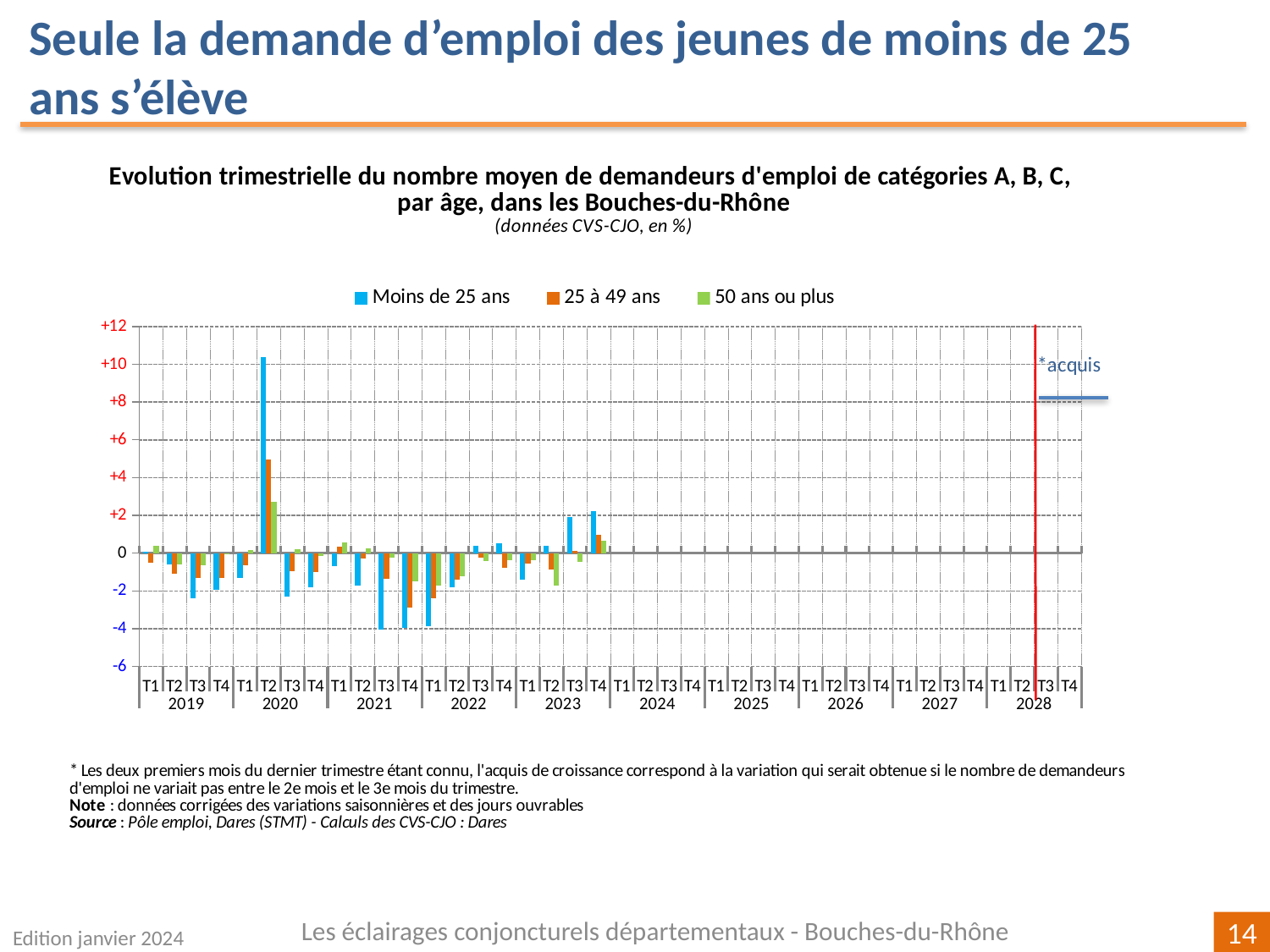
Is the value for '50 ans ou plus' in T2 2020 greater or less than +2? greater In T3 2019, which is larger: the value for 'Moins de 25 ans' or the value for '50 ans ou plus'? 50 ans ou plus In which quarter does the 'Moins de 25 ans' series reach its highest value? T2 2020 What kind of chart is shown on the slide? Bar chart Is the value for '25 à 49 ans' in T2 2020 greater or less than +4? greater In T2 2020, which series has the highest value? Moins de 25 ans How many years are labelled along the x axis? 10 How many series does the legend list? 3 What colour represents the 'Moins de 25 ans' series in the legend? Blue Is the value for 'Moins de 25 ans' in T3 2021 greater or less than -2? less Between T3 2023 and T4 2023, does the value for '50 ans ou plus' rise or fall? Rise